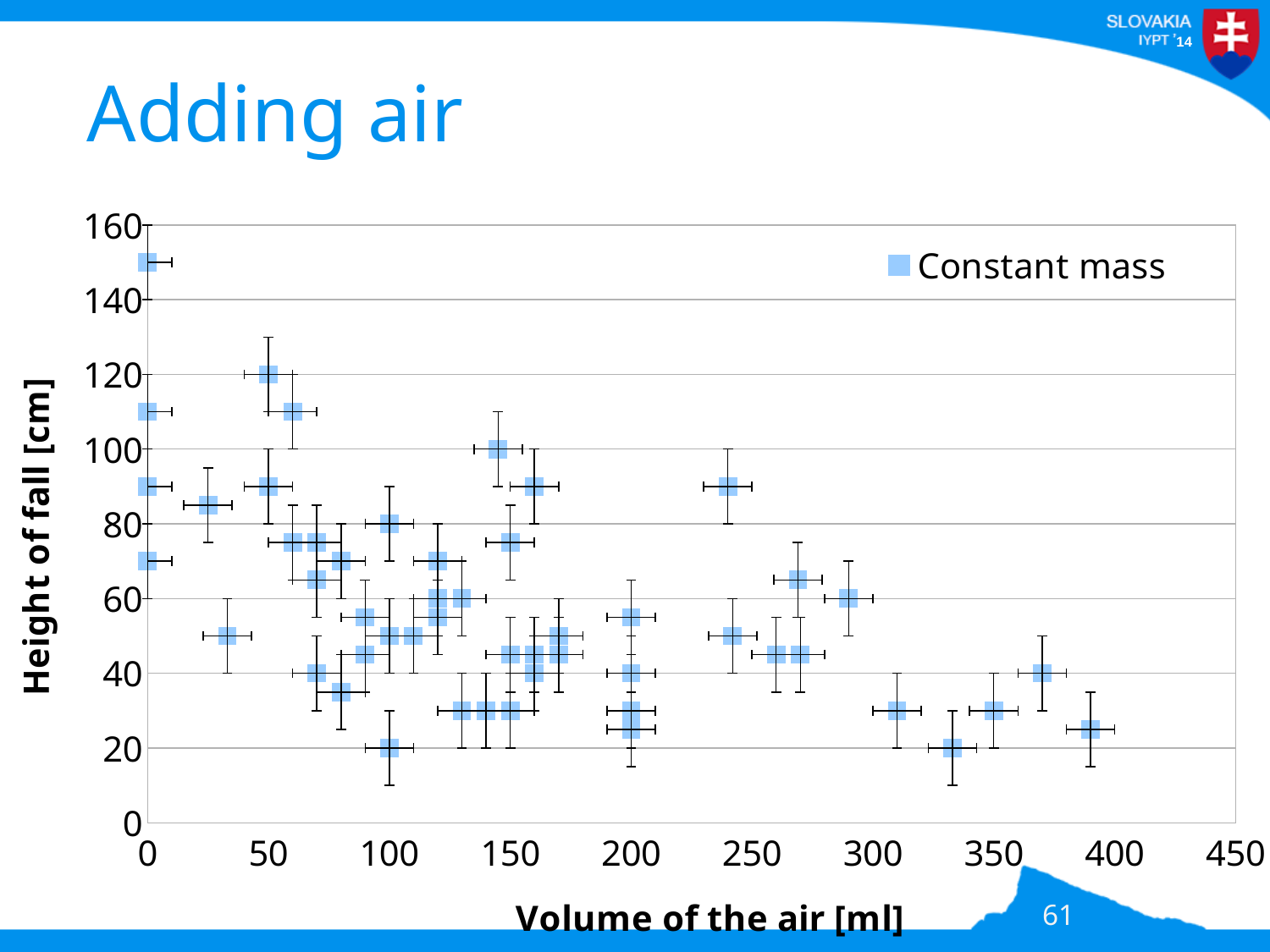
Is the highest height of fall at a volume of 0 ml greater or less than 140? greater What is the label of the vertical axis? Height of fall [cm] As the volume of the air increases along the x axis, does the height of fall generally rise or fall? fall Which is larger: the highest height of fall at 50 ml or the height of fall at about 240 ml? 50 ml At which volume of air is the single highest height of fall recorded? 0 ml Is the height of fall for the point at about 333 ml greater or less than 40? less What is the name of the series shown in the legend? Constant mass Is the height of fall for the point at about 390 ml greater or less than 40? less What is the highest height of fall recorded at a volume of 50 ml? 120 How many series does the legend list? 1 What kind of chart is shown on the slide? scatter chart